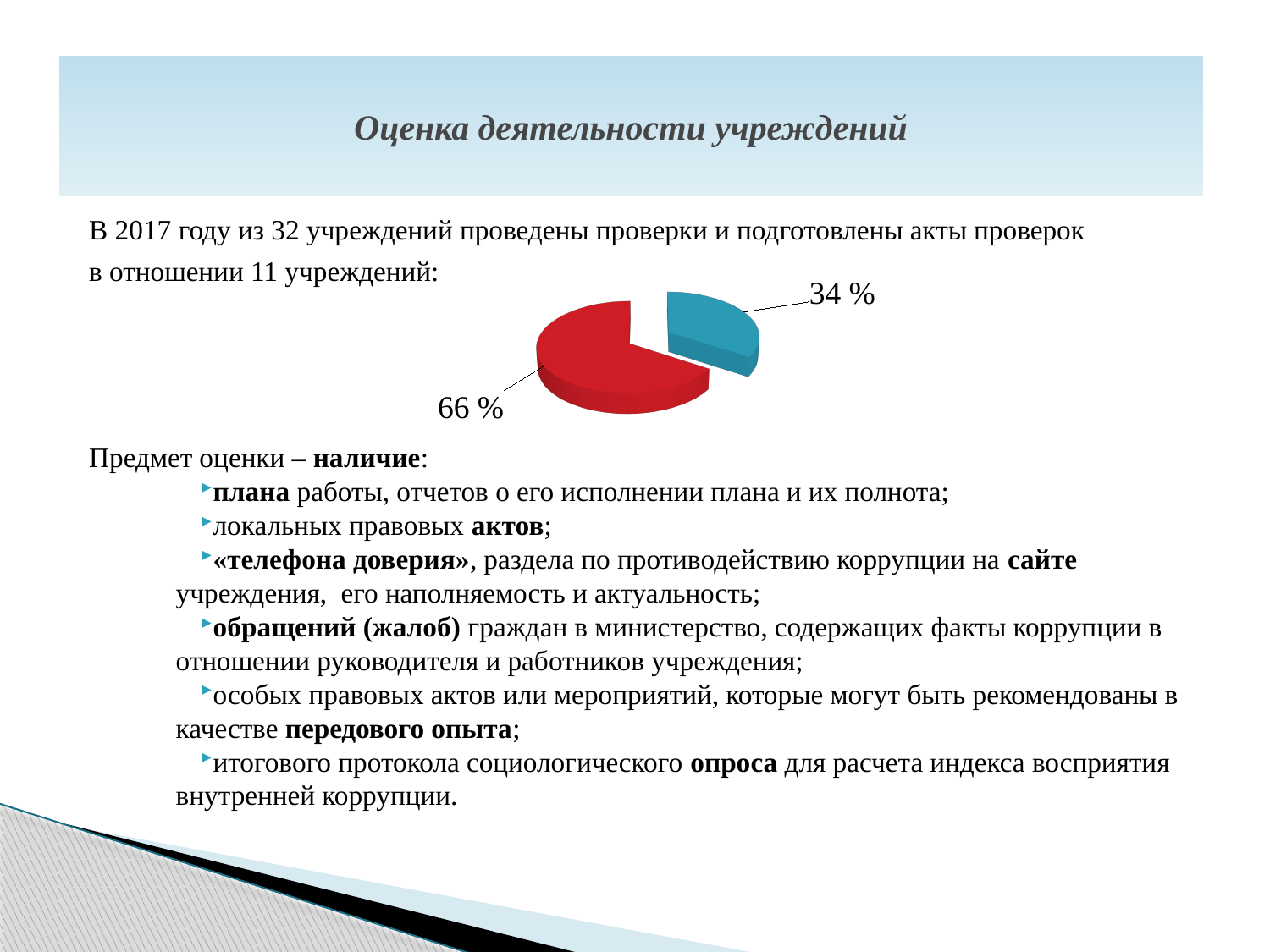
What value is labelled on the red slice of the pie chart? 66 % How many slices does the pie chart have? 2 Which slice of the pie chart is the smallest? the blue slice (34 %) What value is labelled on the blue slice of the pie chart? 34 % What colours are used for the two slices of the pie chart? red and blue Is the value of the red slice of the pie chart greater or less than 50 %? greater Which is larger in the pie chart, the red slice or the blue slice? the red slice What kind of chart is shown on the slide? pie chart What do the two slices of the pie chart add up to? 100 % What share of the pie does the blue slice represent? 34 % What is the difference between the red slice and the blue slice of the pie chart? 32 % Which slice of the pie chart is the largest? the red slice (66 %)